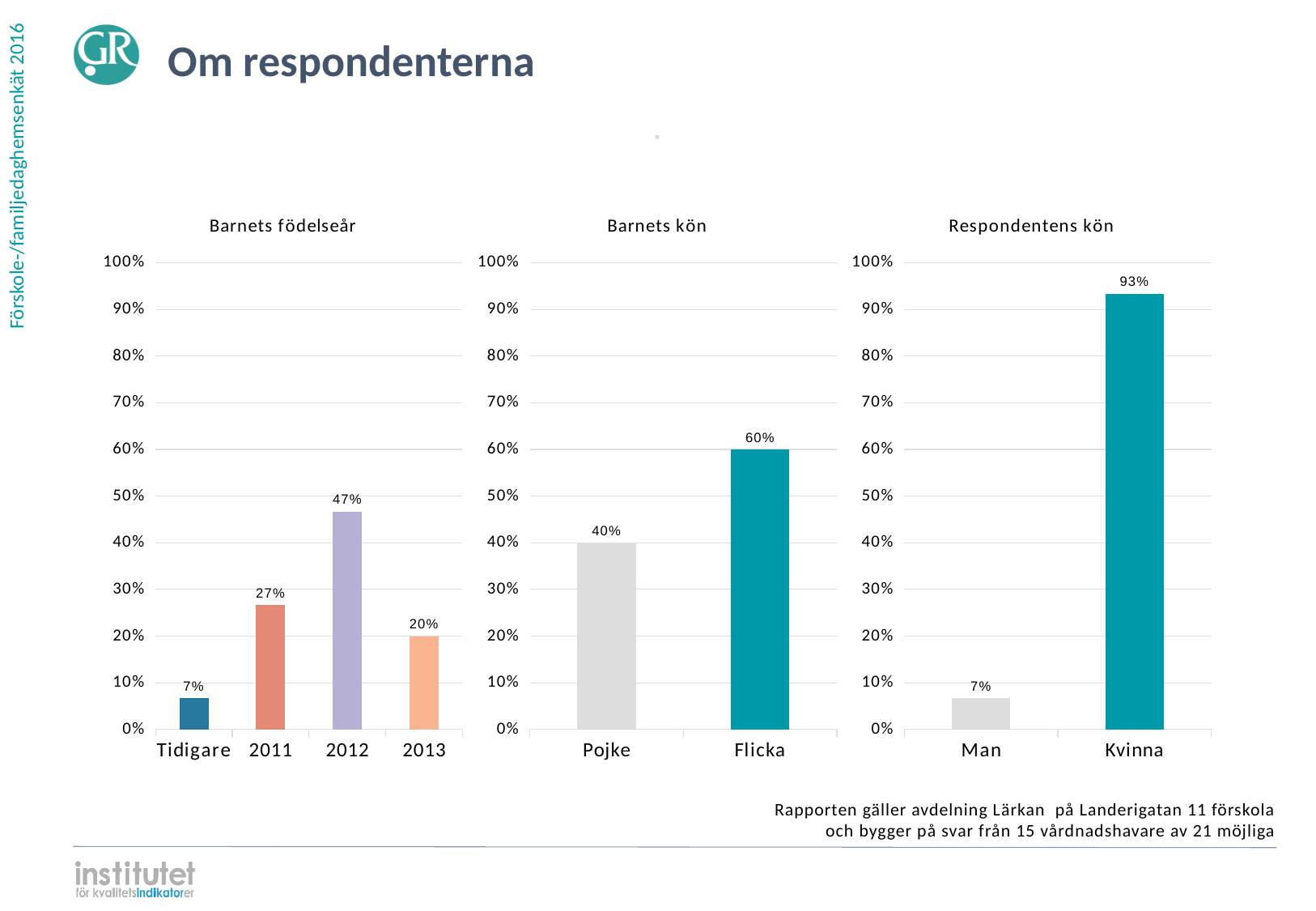
In the 'Respondentens kön' chart, what is the value for Man? 7% In the 'Respondentens kön' chart, what is the value for Kvinna? 93% What is the title of the leftmost chart on the slide? Barnets födelseår In the 'Barnets födelseår' chart, how many categories are shown? 4 In the 'Barnets kön' chart, what is the difference between Flicka and Pojke? 20% In the 'Barnets kön' chart, what is the value for Pojke? 40% In the 'Barnets kön' chart, which is larger, Pojke or Flicka? Flicka What kind of chart is the 'Respondentens kön' chart? Bar chart In the 'Barnets födelseår' chart, what is the value for 2012? 47% In the 'Barnets födelseår' chart, which category has the lowest value? Tidigare In the 'Barnets födelseår' chart, what is the difference between the values for 2011 and 2013? 7% In the 'Barnets födelseår' chart, which category has the highest value? 2012